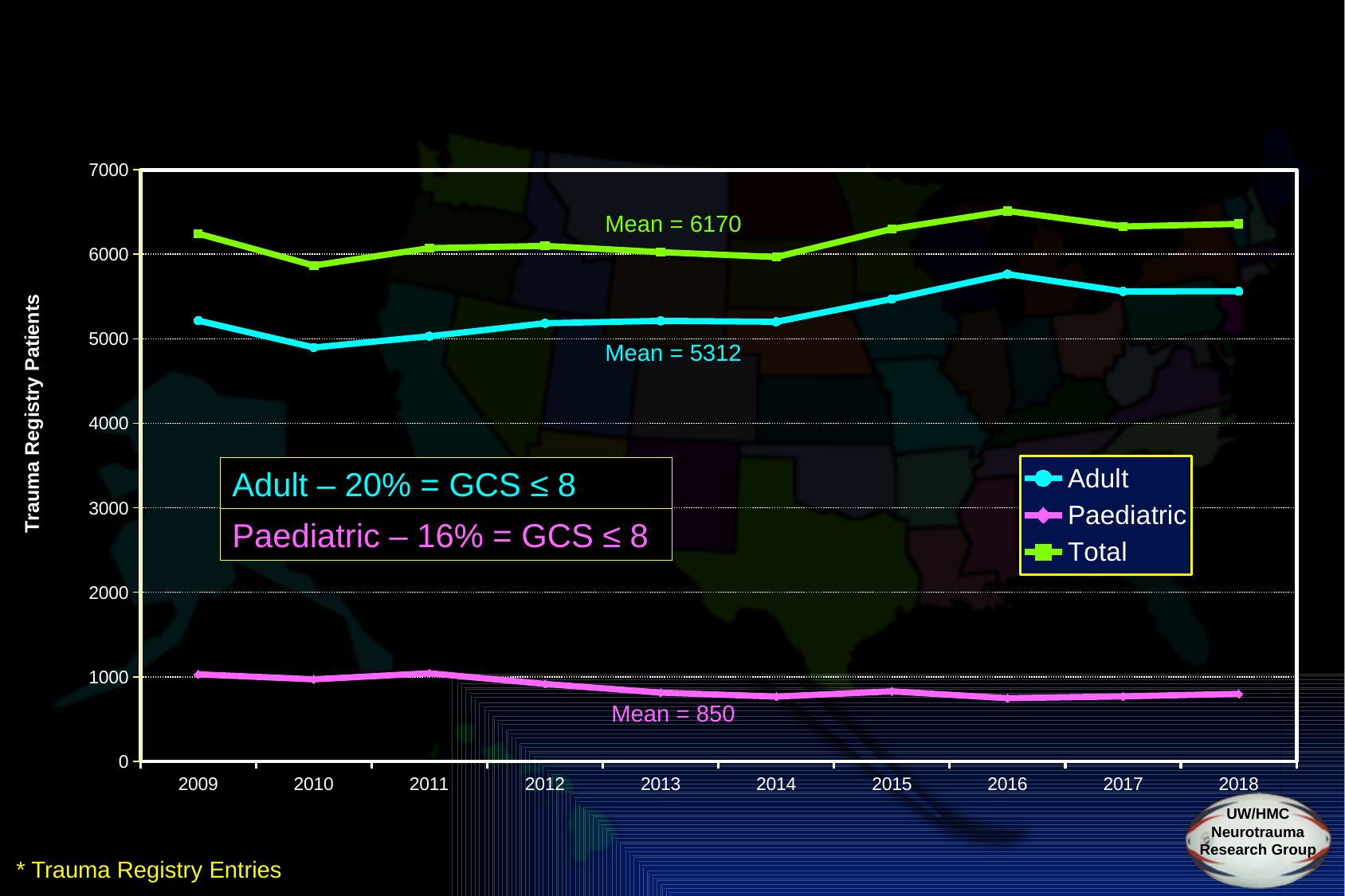
Is the Paediatric value for 2014 greater or less than 1000? less What is the label on the y axis? Trauma Registry Patients Is the Adult value for 2010 greater or less than 5000? less In which year is the Adult series lowest? 2010 Is the Total value for 2010 greater or less than 6000? less How many years are shown on the x axis? 10 Which series has higher values in 2018, Adult or Paediatric? Adult In which year is the Total series lowest? 2010 In which year is the Total series highest? 2016 What mean value is printed for the Total series? Mean = 6170 What kind of chart is shown on the slide? line chart How many series does the legend list? 3